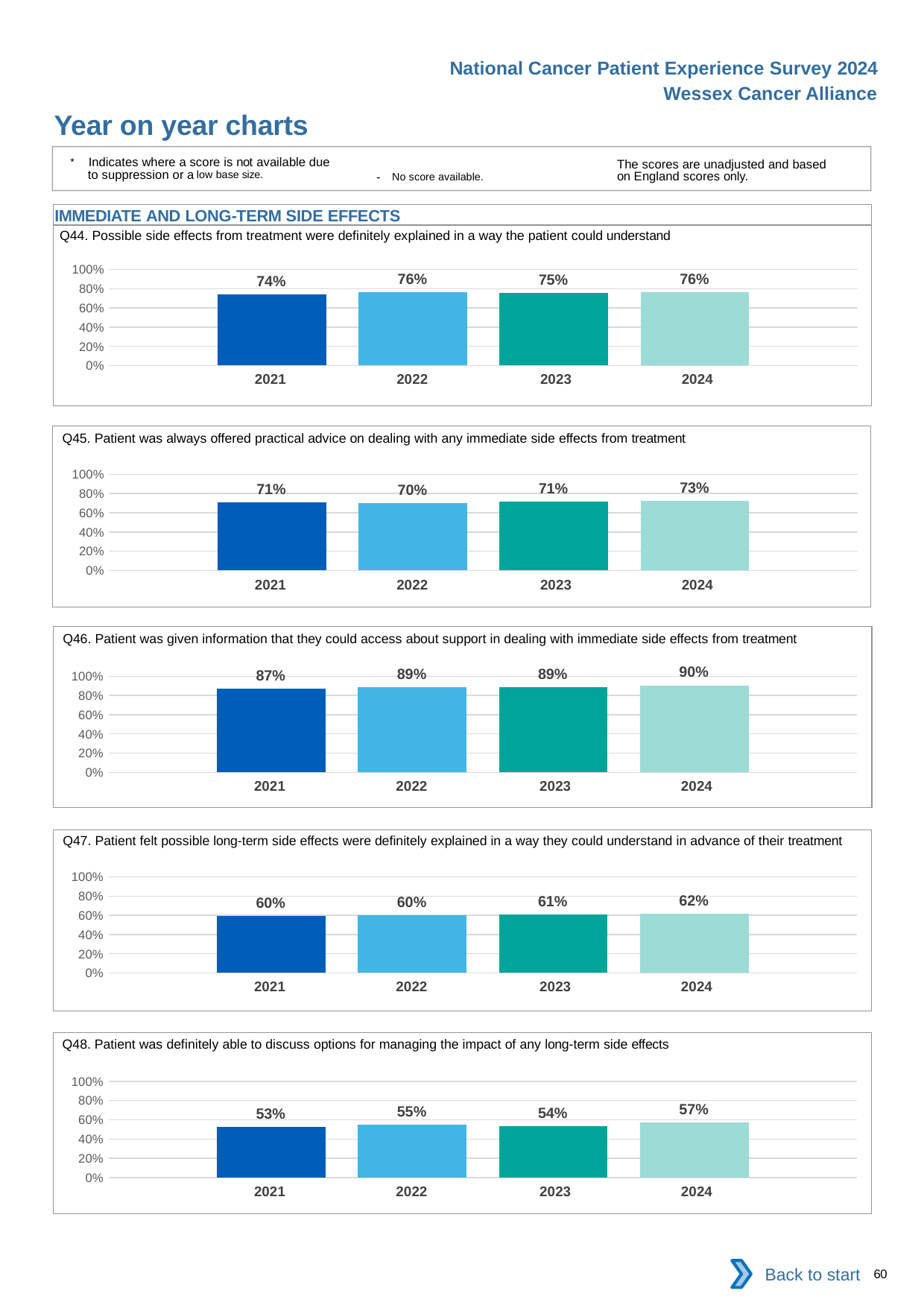
In the Q46 chart, what is the difference between the 2024 value and the 2021 value? 3% In the Q48 chart, is the value for 2021 greater or less than 60%? less In the Q48 chart, which is larger, the value for 2022 or the value for 2023? 2022 What type of chart is used for Q46? bar chart In the Q44 chart, what is the value for 2021? 74% In the Q45 chart, which year has the highest value? 2024 What is the section heading above the Q44 chart? IMMEDIATE AND LONG-TERM SIDE EFFECTS In the Q45 chart, which year has the lowest value? 2022 In the Q47 chart, do the values rise or fall from 2021 to 2024? rise In the Q47 chart, what is the value for 2024? 62% In the Q48 chart, what is the difference between the 2024 value and the 2021 value? 4% How many years are shown on the x axis of the Q44 chart? 4